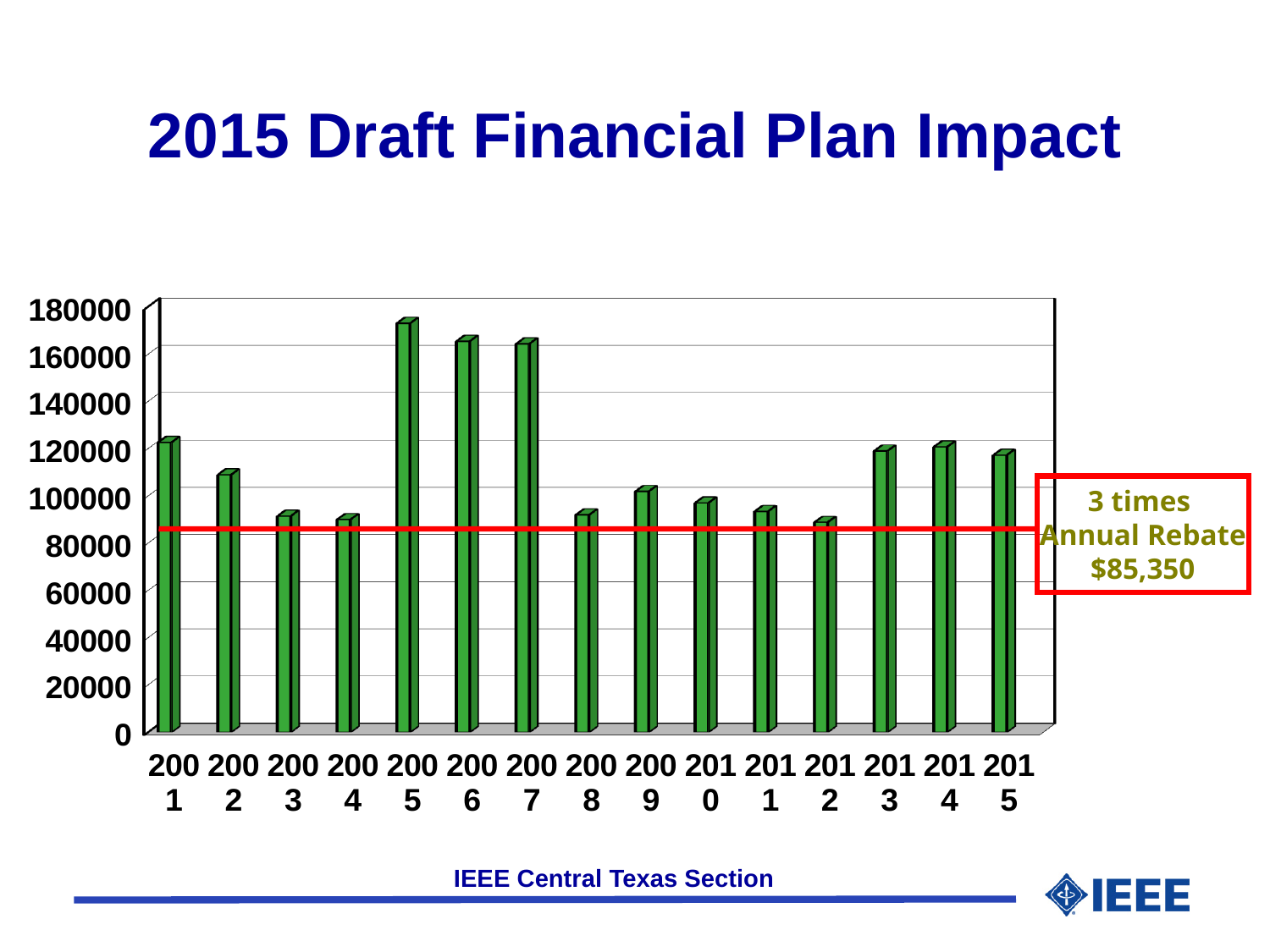
How many years (bars) are plotted in the chart? 15 Is the value for 2012 greater or less than 100000? less Is the value for 2005 greater or less than 160000? greater Which is larger, the value for 2002 or the value for 2003? 2002 Is the value for 2003 greater or less than 100000? less Which is larger, the value for 2014 or the value for 2010? 2014 What dollar amount is labelled on the red horizontal line in the chart? $85,350 Do the values rise or fall from 2005 to 2008? fall What kind of chart is shown on the slide? bar chart Which year has the highest bar in the chart? 2005